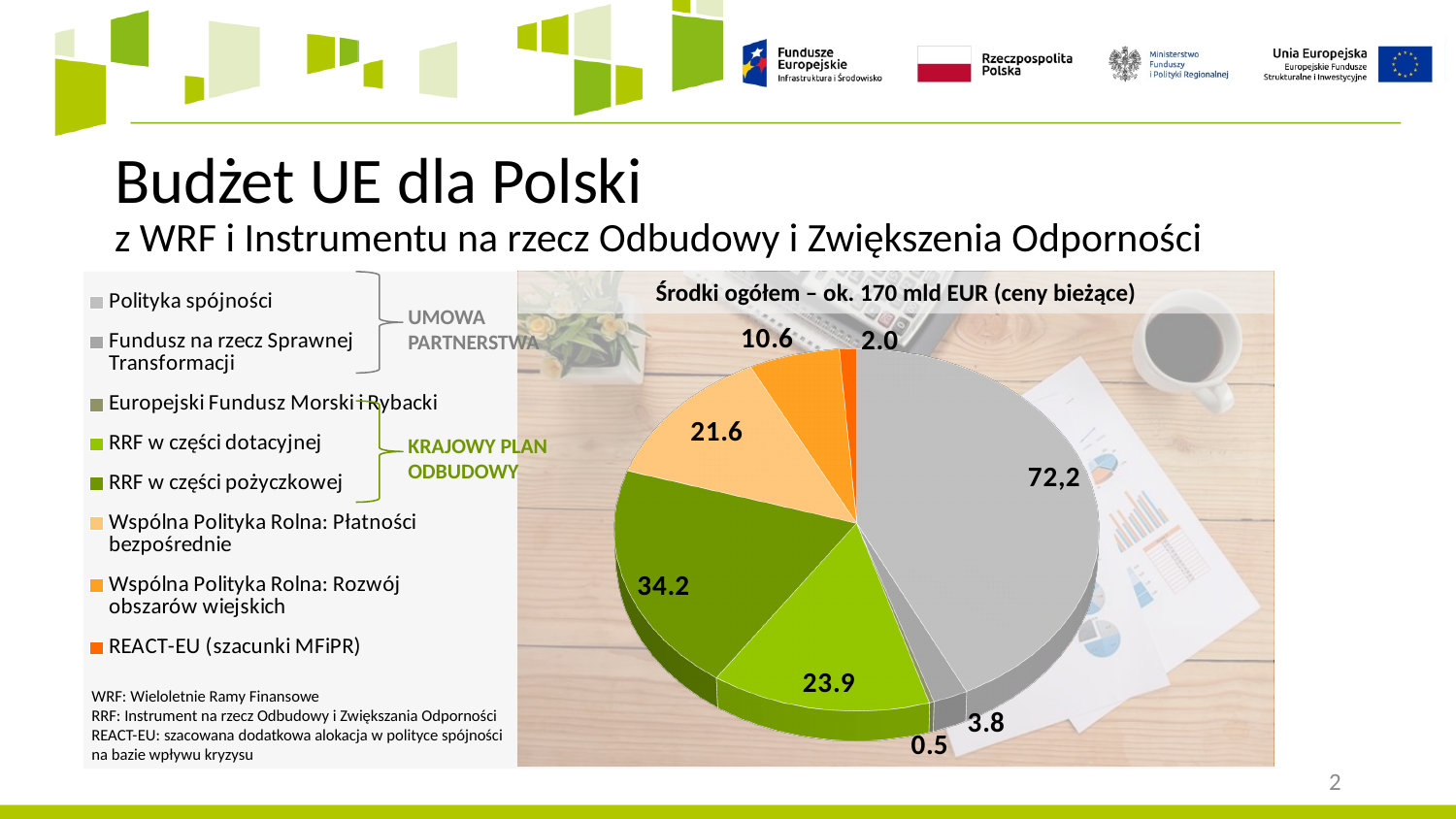
How many slices does the pie chart have? 8 What is the difference between the values for RRF w części pożyczkowej and RRF w części dotacyjnej? 10.3 Which is larger: Wspólna Polityka Rolna: Płatności bezpośrednie or Wspólna Polityka Rolna: Rozwój obszarów wiejskich? Wspólna Polityka Rolna: Płatności bezpośrednie Which category has the largest slice of the pie chart? Polityka spójności What is the value shown for RRF w części dotacyjnej? 23.9 Which category has the smallest slice of the pie chart? Europejski Fundusz Morski i Rybacki What is the value shown for Wspólna Polityka Rolna: Płatności bezpośrednie? 21.6 What is the title of the pie chart? Środki ogółem – ok. 170 mld EUR (ceny bieżące) What is the value shown for Polityka spójności in the pie chart? 72,2 What is the value shown for RRF w części pożyczkowej? 34.2 What is the value shown for REACT-EU (szacunki MFiPR)? 2.0 What type of chart is shown on the slide? pie chart